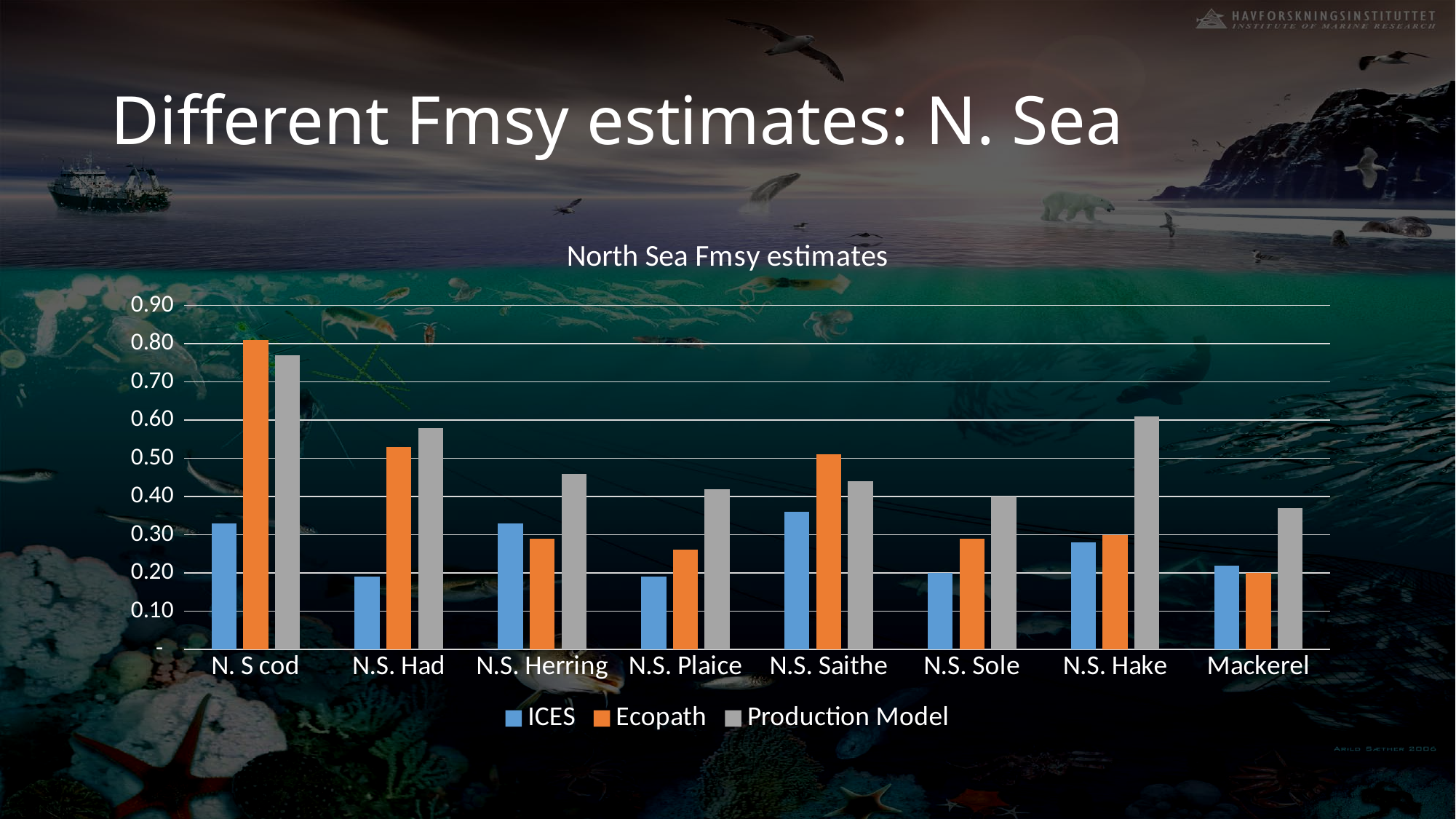
For N.S. Hake, which is larger: the Ecopath value or the Production Model value? Production Model What is the title of the chart? North Sea Fmsy estimates Is the Ecopath value for N. S cod greater or less than 0.70? greater How many stock categories are shown on the x axis? 8 Is the ICES value for N.S. Saithe greater or less than 0.30? greater What kind of chart is shown on the slide? bar chart Which category has the highest Ecopath value? N. S cod For N.S. Herring, which is larger: the ICES value or the Ecopath value? ICES Which category has the lowest Ecopath value? Mackerel Is the Production Model value for N.S. Herring greater or less than 0.40? greater Which category has the highest Production Model value? N. S cod How many series does the legend list? 3